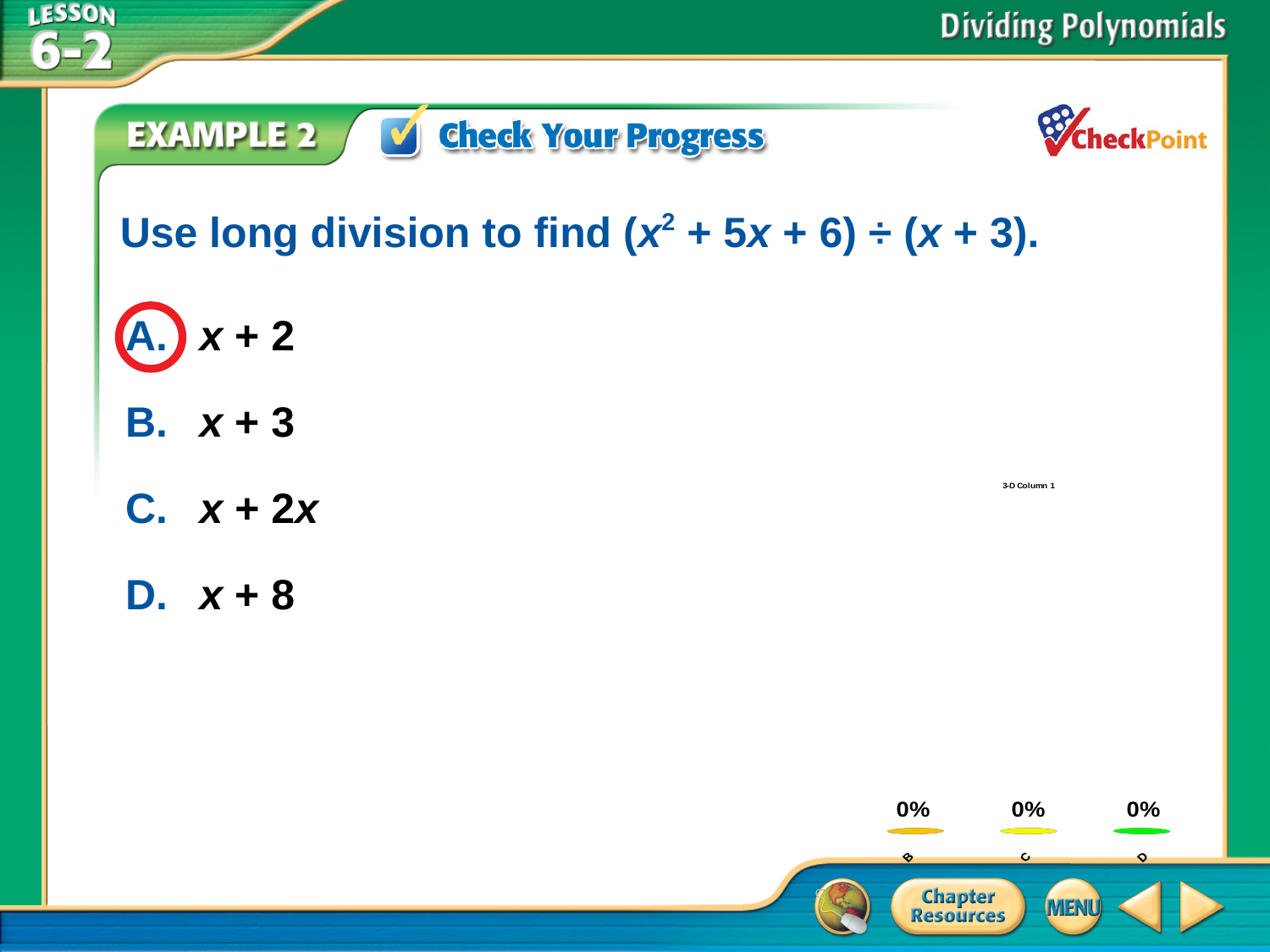
What value is shown for category D in the chart at the bottom right of the slide? 0% What value is shown for category B in the chart at the bottom right of the slide? 0% What is the title printed on the chart at the bottom right of the slide? 3-D Column 1 What kind of chart is shown at the bottom right of the slide? bar chart What is the difference between the values for B and D in the chart at the bottom right of the slide? 0% Do the values in the chart at the bottom right of the slide rise, fall, or stay the same from B to D? stay the same What value is shown for category C in the chart at the bottom right of the slide? 0%